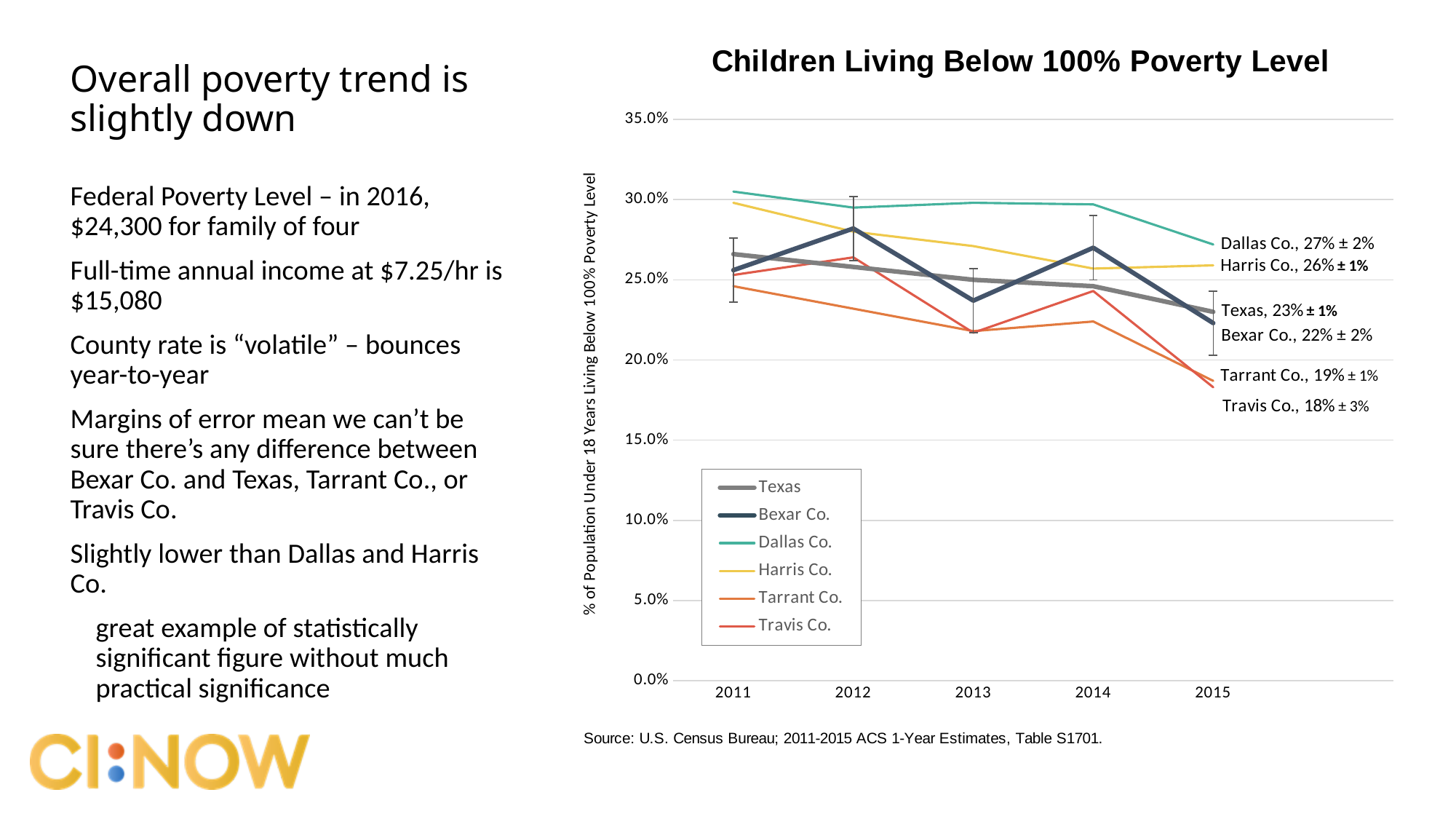
In 2015, which is larger: the value for Harris Co. or the value for Texas? Harris Co. Which series has the lowest value in 2015? Travis Co. What kind of chart is shown on the slide? line chart What is the difference between the 2015 values for Dallas Co. (27%) and Travis Co. (18%)? 9 percentage points What is the labelled value for Travis Co. in 2015? 18% ± 3% What is the labelled value for Bexar Co. in 2015? 22% ± 2% How many years are shown on the x axis? 5 Which series has the highest value in 2015? Dallas Co. How many series does the legend list? 6 Does the Texas line rise or fall from 2011 to 2015? fall What is the labelled value for Dallas Co. in 2015? 27% ± 2% Is the value for Bexar Co. in 2012 greater or less than 25.0%? greater